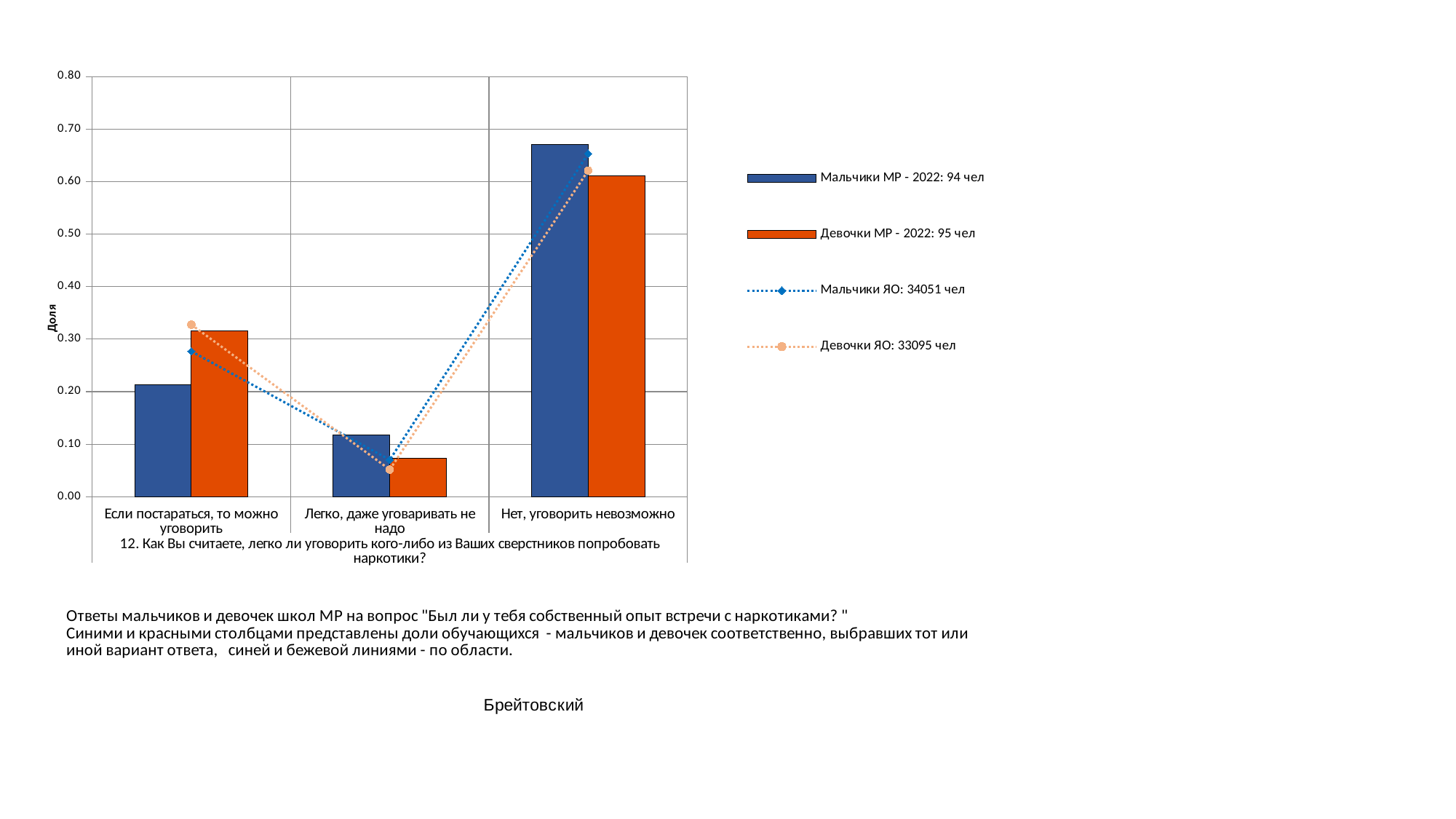
What is the title of the vertical axis? Доля For the series Девочки МР - 2022, which category has the lowest bar? Легко, даже уговаривать не надо What kind of chart is shown on the slide? A bar chart combined with dotted line series For the series Мальчики МР - 2022, which category has the highest bar? Нет, уговорить невозможно Is the value for Девочки МР - 2022 in the category "Легко, даже уговаривать не надо" greater or less than 0.10? less How many answer categories are shown on the x axis? 3 In the category "Легко, даже уговаривать не надо", which bar is taller: Мальчики МР - 2022 or Девочки МР - 2022? Мальчики МР - 2022 Is the value for Мальчики МР - 2022 in the category "Нет, уговорить невозможно" greater or less than 0.60? greater According to the legend, how many people are in the Мальчики ЯО series? 34051 чел How many series does the legend list? 4 Is the value for Мальчики МР - 2022 in the category "Если постараться, то можно уговорить" greater or less than 0.30? less In the category "Если постараться, то можно уговорить", which bar is taller: Мальчики МР - 2022 or Девочки МР - 2022? Девочки МР - 2022